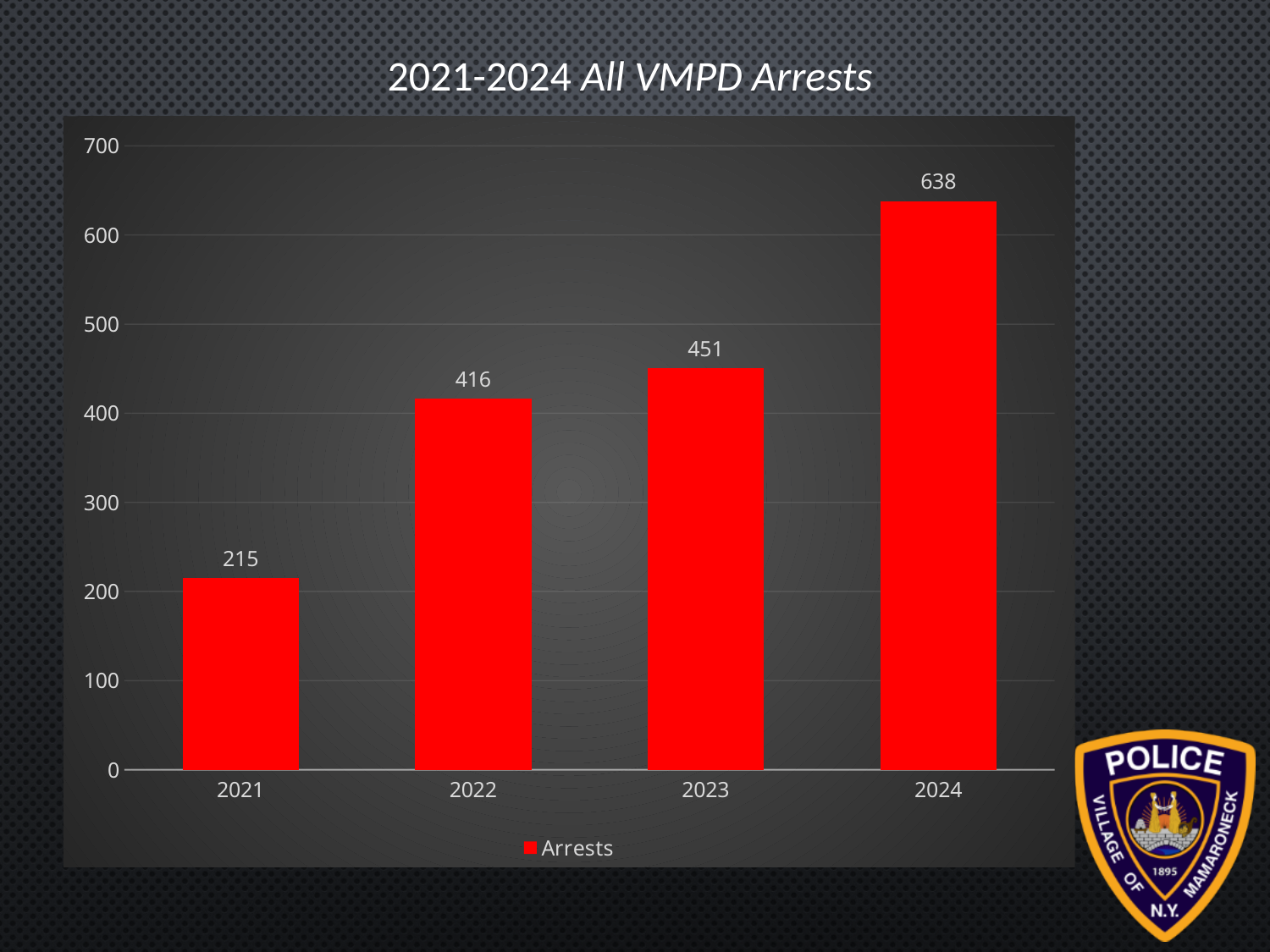
What is the difference in arrests between 2022 and 2021? 201 What is the number of arrests in 2024? 638 What is the difference in arrests between 2024 and 2023? 187 Do the arrest values rise or fall from 2021 to 2024? Rise How many arrests were there in 2021? 215 Which year had more arrests, 2022 or 2023? 2023 How many arrests are shown for 2023? 451 Which year has the lowest number of arrests? 2021 Which year has the highest number of arrests? 2024 What kind of chart is this? Bar chart How many years are shown on the x axis? 4 What is the value for 2022? 416